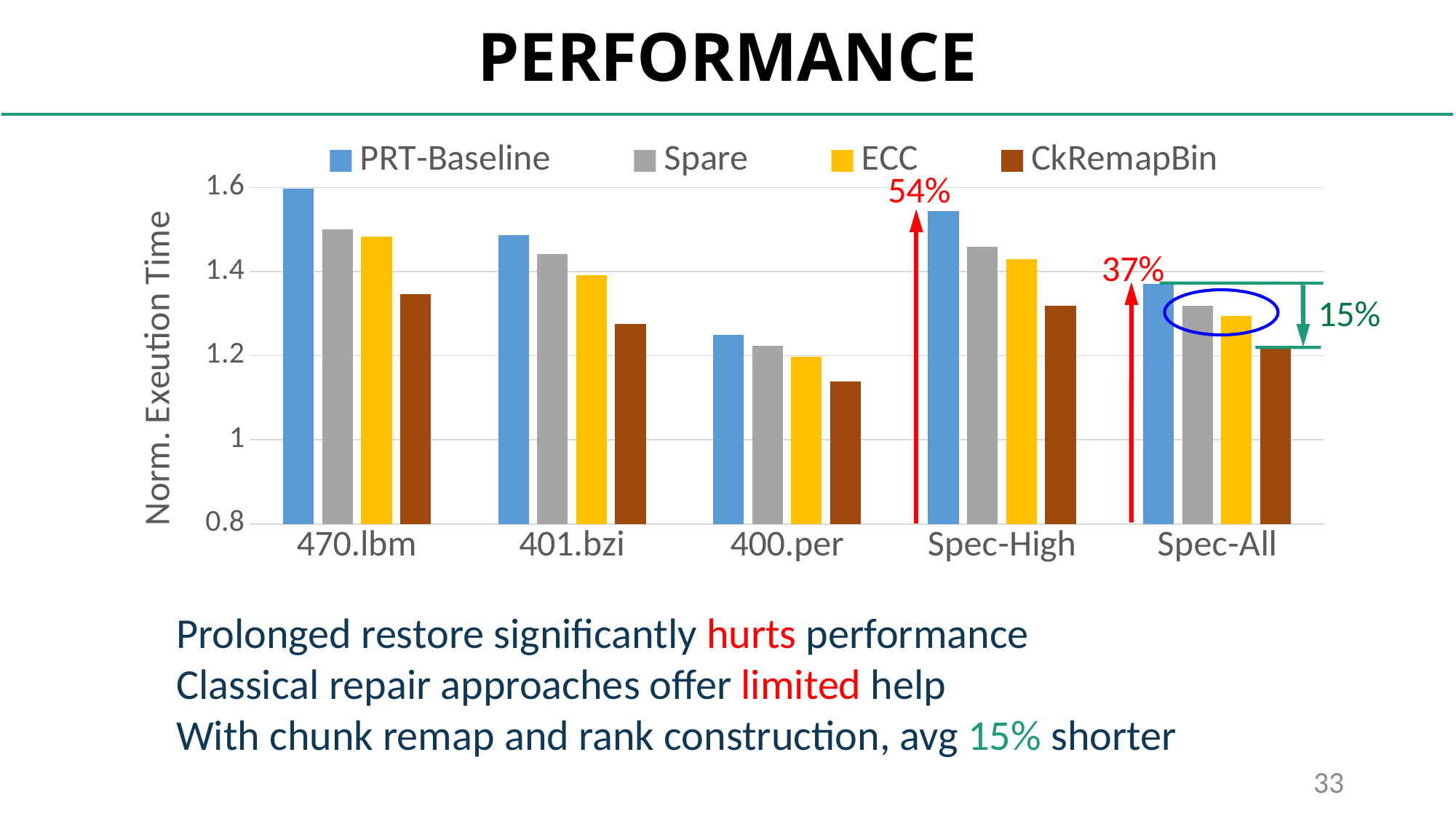
For 401.bzi, which is larger: the Spare value or the ECC value? Spare Is the Spare value for Spec-High greater or less than 1.4? greater Is the PRT-Baseline value for 400.per greater or less than 1.4? less How many categories are shown on the x axis? 5 Which category has the highest PRT-Baseline value? 470.lbm What percentage is annotated in red above the Spec-High group? 54% Which is larger: the PRT-Baseline value for Spec-High or for Spec-All? Spec-High Within the 470.lbm group, do the bars rise or fall going from PRT-Baseline to CkRemapBin? fall Is the CkRemapBin value for 470.lbm greater or less than 1.2? greater Which category has the lowest CkRemapBin value? 400.per What kind of chart is shown on the slide? bar chart How many series does the legend list? 4